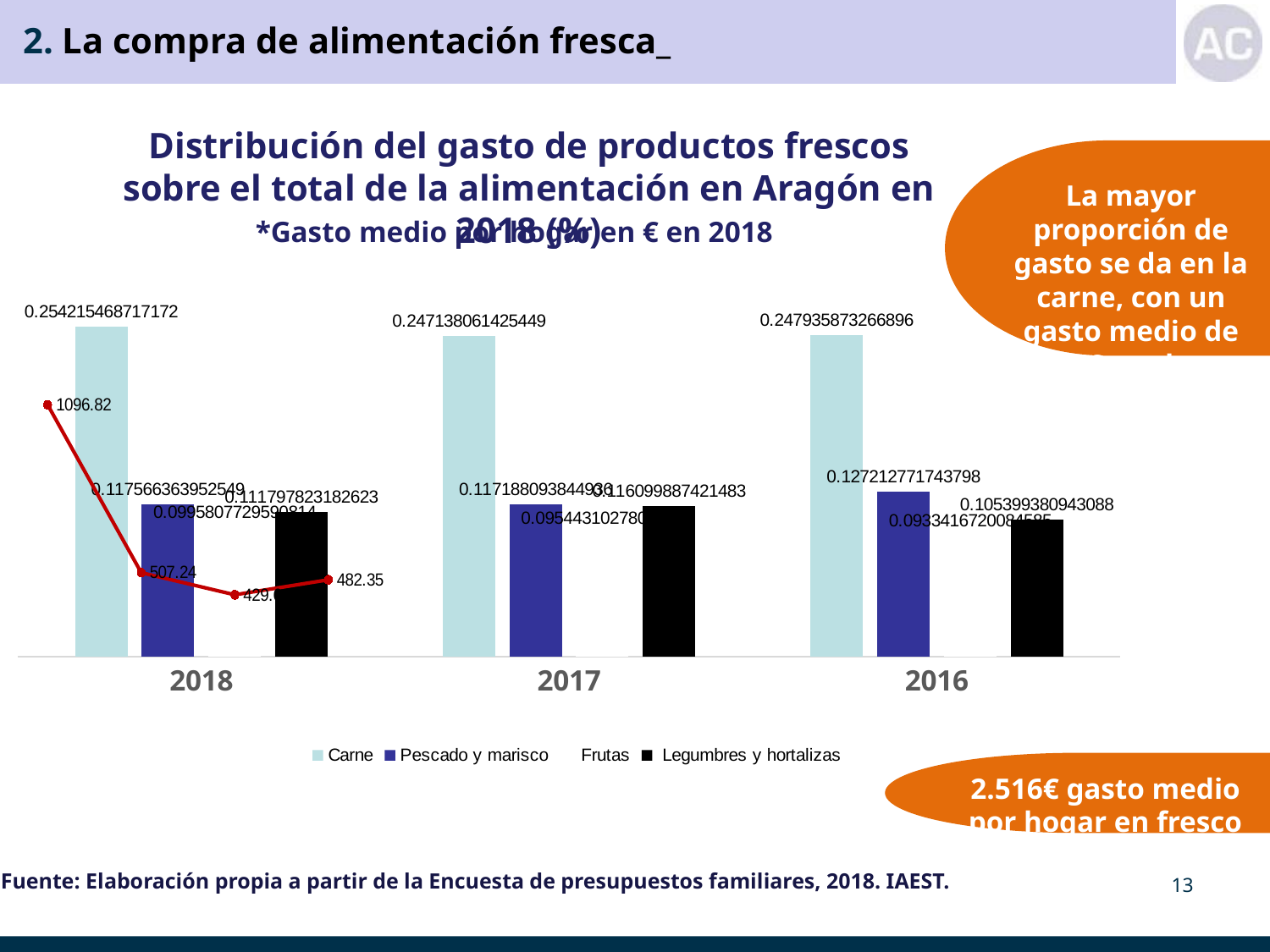
What is the value for Legumbres y hortalizas in 2016? 0.105399380943088 How many series does the legend list? 4 What is the value for Carne in 2018? 0.254215468717172 What is the value for Carne in 2017? 0.247138061425449 What is the value for Carne in 2016? 0.247935873266896 What is the average spending per household in € for Carne in 2018, shown on the red line? 1096.82 In 2016, which is larger: Pescado y marisco or Legumbres y hortalizas? Pescado y marisco Which series has the highest value in 2018? Carne What is the value for Pescado y marisco in 2016? 0.127212771743798 What is the value for Legumbres y hortalizas in 2018? 0.111797823182623 How many years are shown on the x axis? 3 What kind of chart is shown on the slide? bar chart